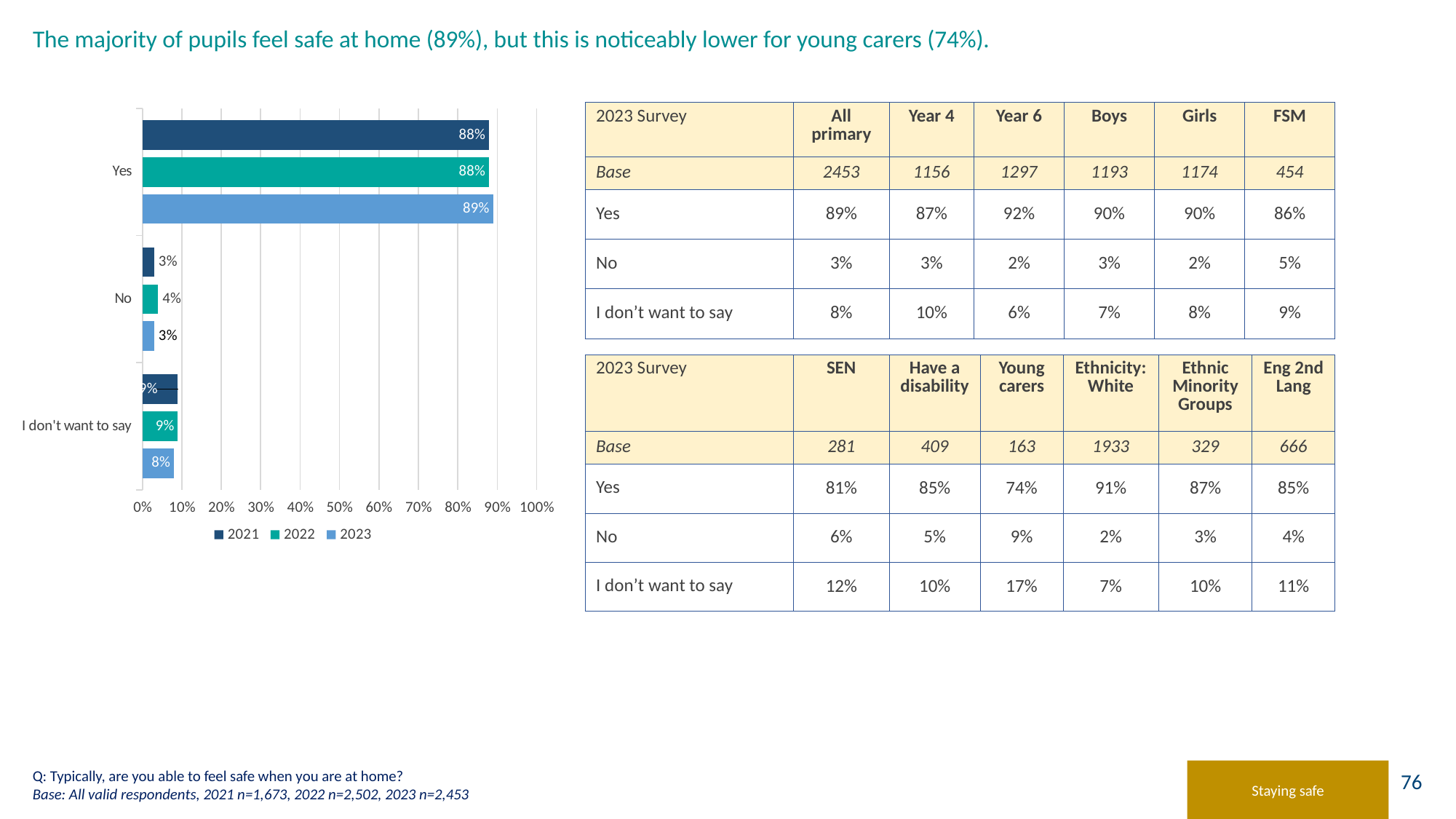
How many response categories are shown on the chart? 3 How many series does the chart legend list? 3 What is the difference between the 2023 'Yes' value and the 2022 'Yes' value on the chart? 1% What is the value for 'I don't want to say' in 2023 on the chart? 8% Which response category has the lowest value in 2022 on the chart? No What is the value for 'Yes' in 2023 on the chart? 89% Which response category has the highest value in 2023 on the chart? Yes What is the value for 'Yes' in 2021 on the chart? 88% What type of chart is shown on the slide? bar chart What is the value for 'No' in 2022 on the chart? 4% Which series is shown in the darkest blue colour in the chart legend? 2021 What is the value for 'No' in 2023 on the chart? 3%